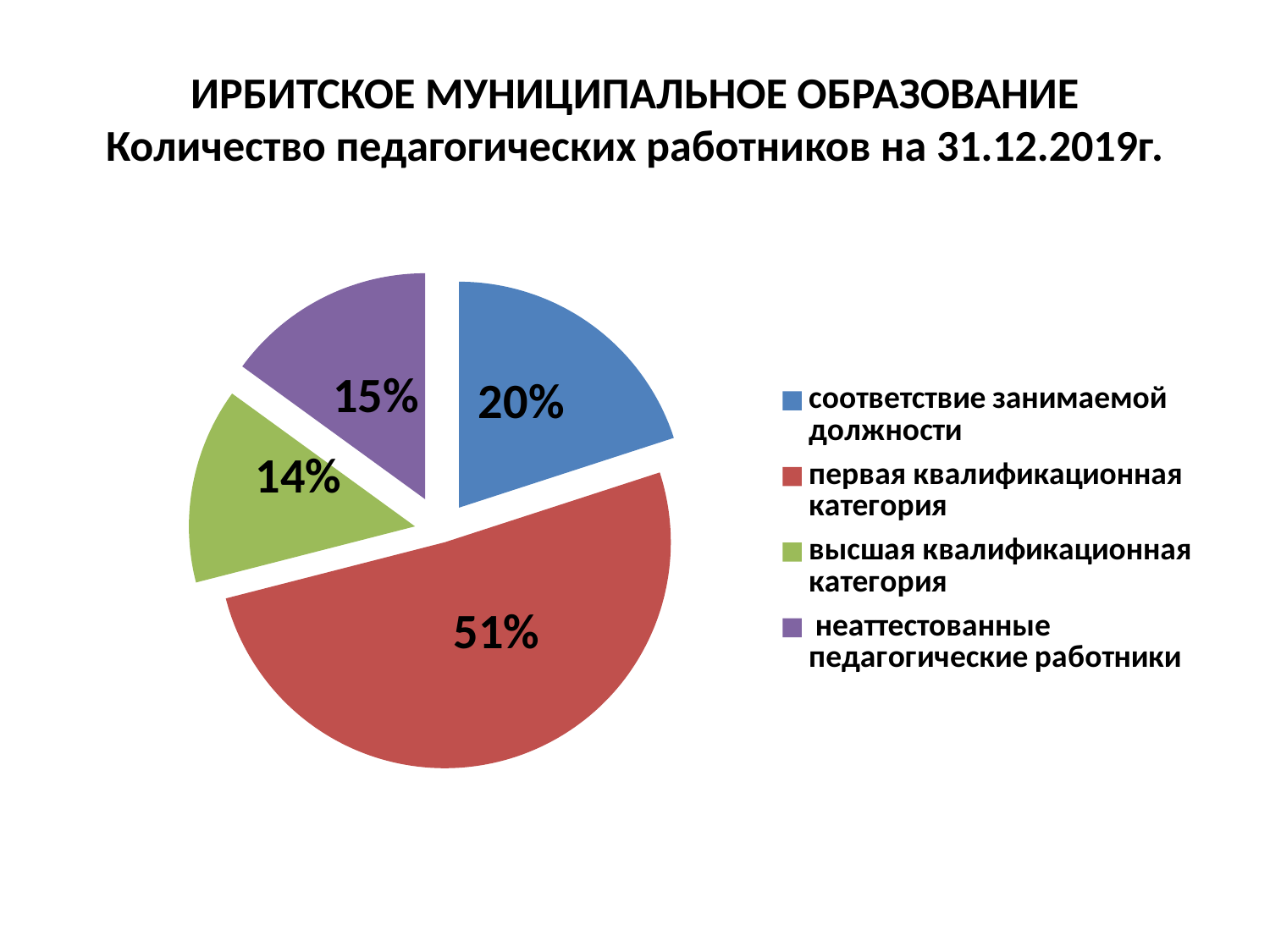
What share of the pie is labelled 'первая квалификационная категория'? 51% How many slices does the pie chart have? 4 How many entries does the legend list? 4 What share of the pie is labelled 'неаттестованные педагогические работники'? 15% What share of the pie is labelled 'высшая квалификационная категория'? 14% Which category has the smallest slice of the pie? высшая квалификационная категория What is the difference in percentage points between 'первая квалификационная категория' and 'соответствие занимаемой должности'? 31 What kind of chart is shown on the slide? pie chart Which is larger: the share for 'неаттестованные педагогические работники' or the share for 'высшая квалификационная категория'? неаттестованные педагогические работники Which category has the largest slice of the pie? первая квалификационная категория What colour is the slice for 'первая квалификационная категория'? red